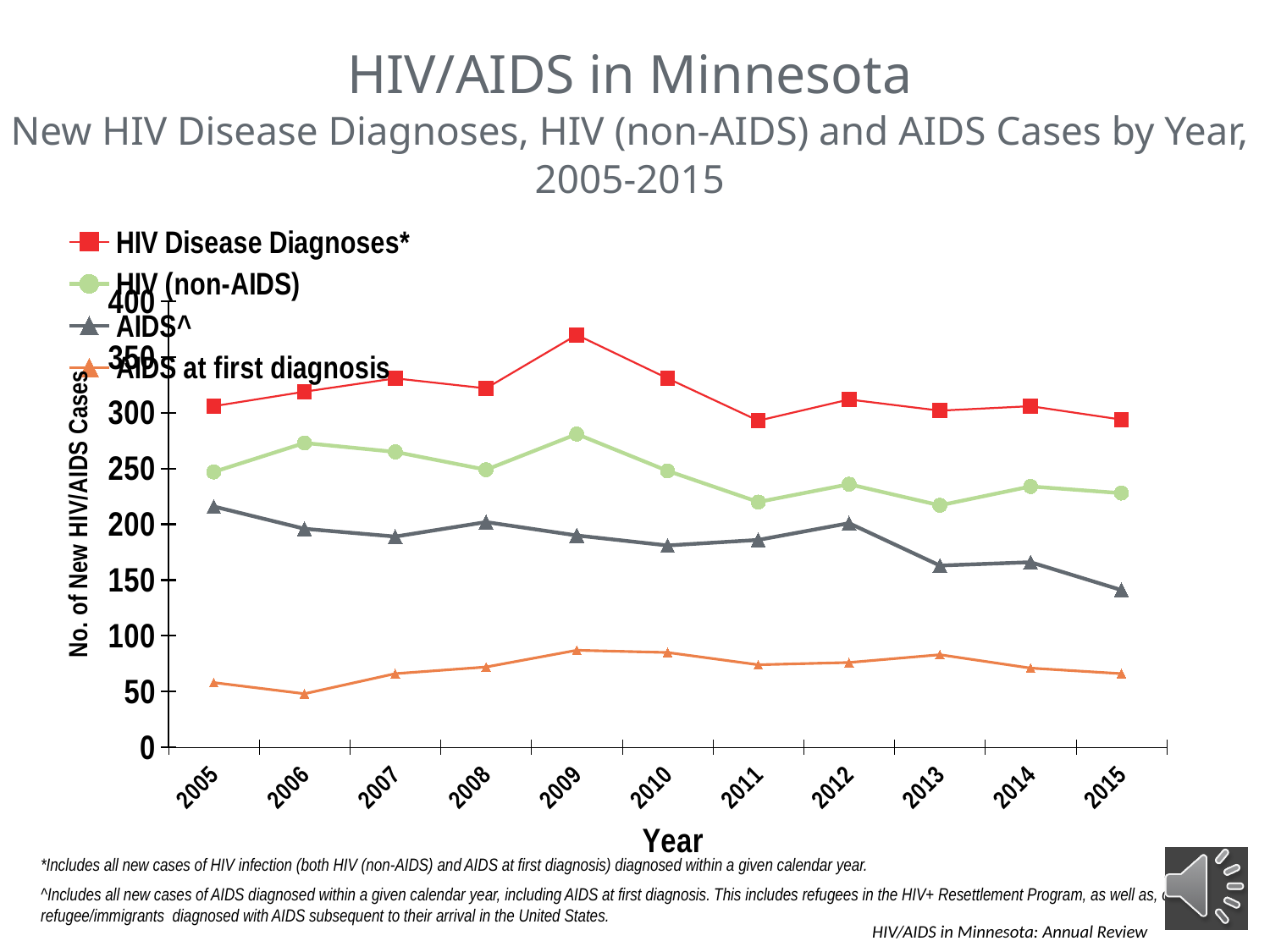
In which year does the AIDS^ series reach its lowest value? 2015 Does the AIDS^ series generally rise or fall from 2005 to 2015? Fall What is the title of the y axis? No. of New HIV/AIDS Cases Is the value for AIDS^ in 2015 greater or less than 150? less In which year does the AIDS at first diagnosis series reach its lowest value? 2006 Is the value for AIDS at first diagnosis in 2009 greater or less than 100? less In which year does the HIV Disease Diagnoses* series reach its highest value? 2009 How many years are plotted along the x axis? 11 Is the value for HIV Disease Diagnoses* in 2009 greater or less than 350? greater What kind of chart is shown on the slide? Line chart Which is larger for the AIDS^ series: the value in 2005 or the value in 2015? 2005 How many series does the legend list? 4